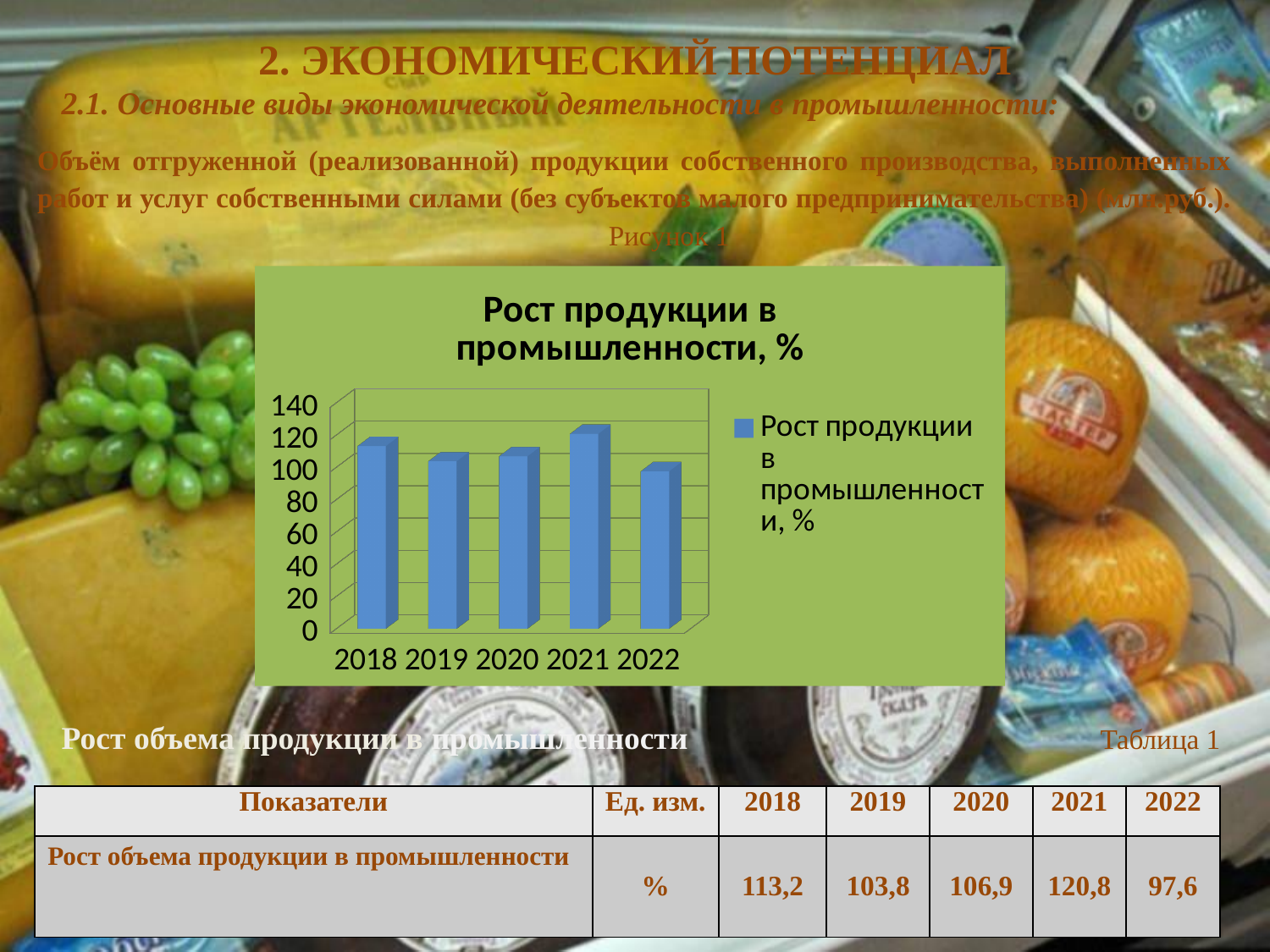
According to the table on the slide, what is the value of industrial output growth for 2022? 97,6 Which year has the lowest bar in the chart? 2022 Is the value for 2021 greater or less than 120? greater Is the value for 2018 greater or less than 100? greater Which year has the highest bar in the chart? 2021 What kind of chart is shown on the slide? bar chart Which is larger, the value for 2018 or the value for 2019? 2018 What is the title of the chart? Рост продукции в промышленности, % Is the value for 2022 greater or less than 100? less How many series does the chart legend list? 1 How many years are plotted on the x axis of the chart? 5 According to the table on the slide, what is the value of industrial output growth for 2021? 120,8